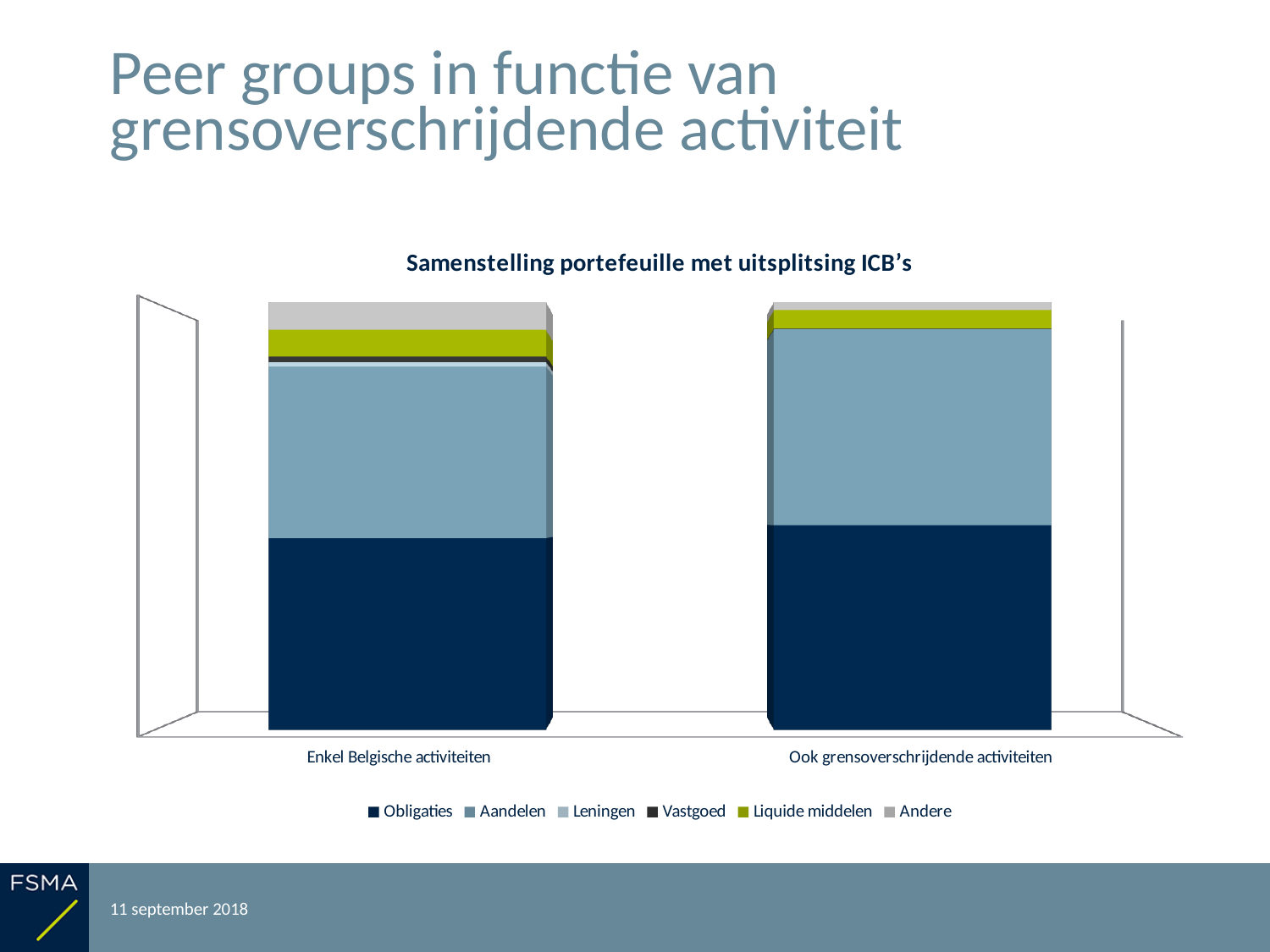
How many categories are shown on the x axis of the chart? 2 Which category has the larger 'Vastgoed' segment, 'Enkel Belgische activiteiten' or 'Ook grensoverschrijdende activiteiten'? Enkel Belgische activiteiten Which series is shown at the bottom of each stacked bar? Obligaties Which category has the larger 'Aandelen' segment, 'Enkel Belgische activiteiten' or 'Ook grensoverschrijdende activiteiten'? Ook grensoverschrijdende activiteiten How many series does the chart's legend list? 6 Within the 'Ook grensoverschrijdende activiteiten' bar, which series has the largest segment? Obligaties Within the 'Enkel Belgische activiteiten' bar, which series has the largest segment? Obligaties What is the title of the chart? Samenstelling portefeuille met uitsplitsing ICB's What kind of chart is shown on the slide? Stacked bar chart Which category has the larger 'Andere' segment, 'Enkel Belgische activiteiten' or 'Ook grensoverschrijdende activiteiten'? Enkel Belgische activiteiten